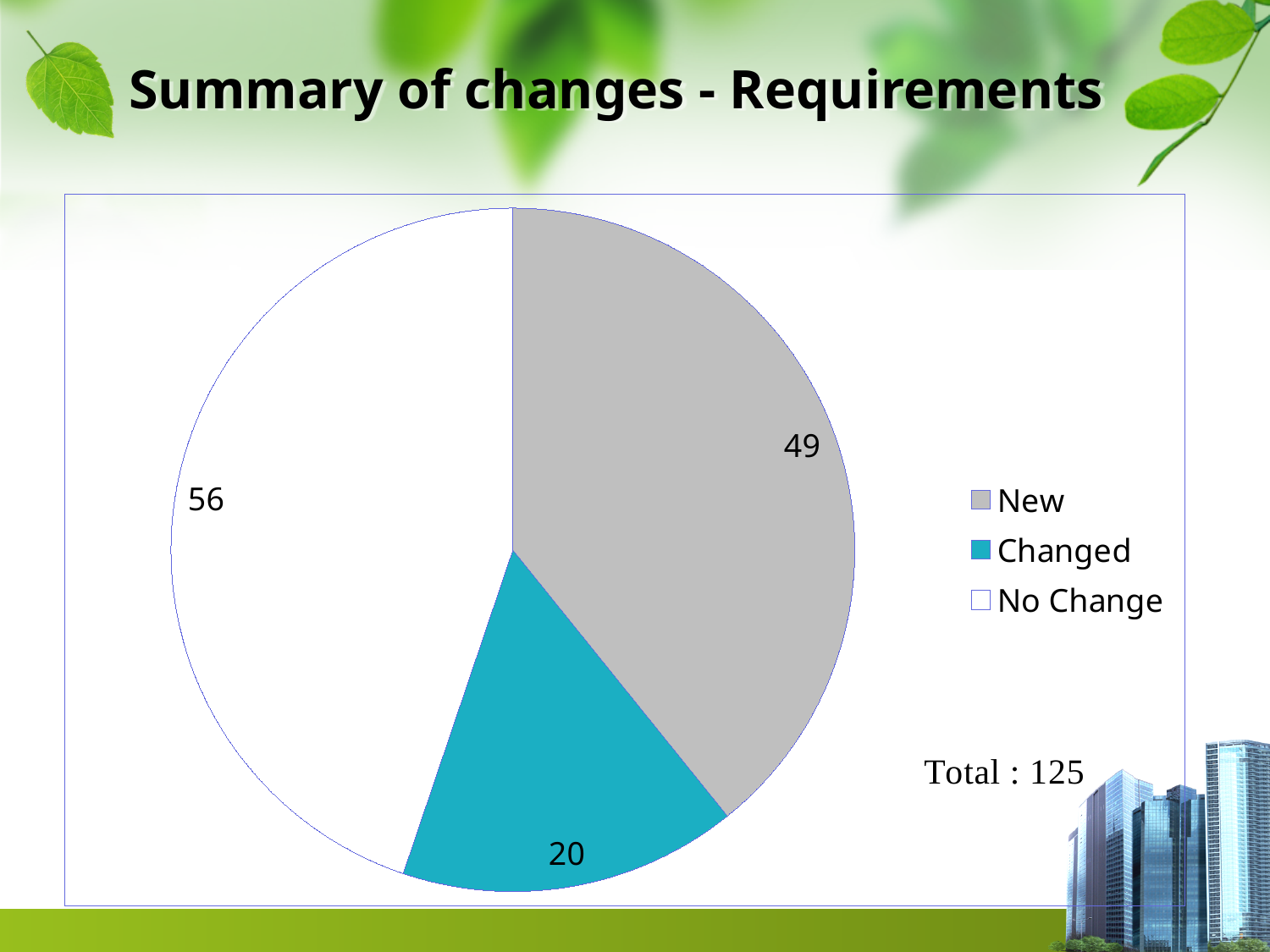
What kind of chart is shown on the slide? pie chart How many slices does the pie chart have? 3 Which category has the smallest slice of the pie? Changed What total is stated next to the pie chart? 125 What share of the pie does the Changed slice represent? 16% What is the value for the New slice? 49 What is the difference between the New value and the Changed value? 29 Which is larger, the value for New or the value for Changed? New What is the difference between the No Change value and the New value? 7 Which category has the largest slice of the pie? No Change What is the value for the No Change slice? 56 What is the value for the Changed slice? 20